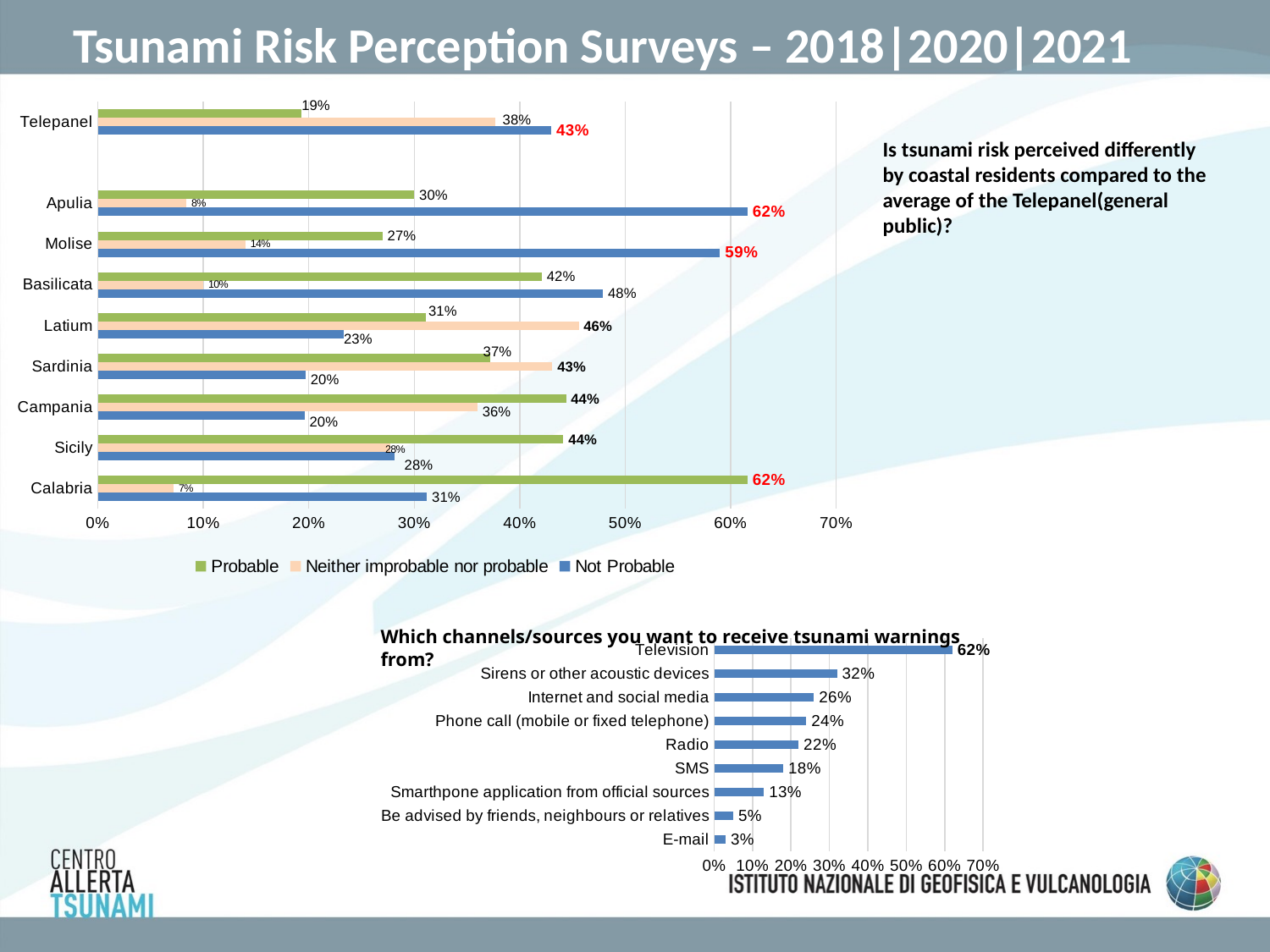
How many series does the legend of the top chart list? 3 In the top chart, what is the 'Neither improbable nor probable' value for Latium? 46% In the top chart, which is larger for Sardinia: 'Probable' or 'Not Probable'? Probable In the top chart, which region has the highest 'Probable' value? Calabria In the bottom chart, which channel has the highest value? Television In the top chart, what is the 'Probable' value for Calabria? 62% In the top chart, what is the 'Not Probable' value for Apulia? 62% In the top chart, what is the difference between the 'Not Probable' values for Molise and Telepanel? 16% How many categories are shown on the top chart? 9 In the top chart, which category has the lowest 'Neither improbable nor probable' value? Calabria In the bottom chart, what is the value for SMS? 18% What kind of chart is the bottom chart? Bar chart